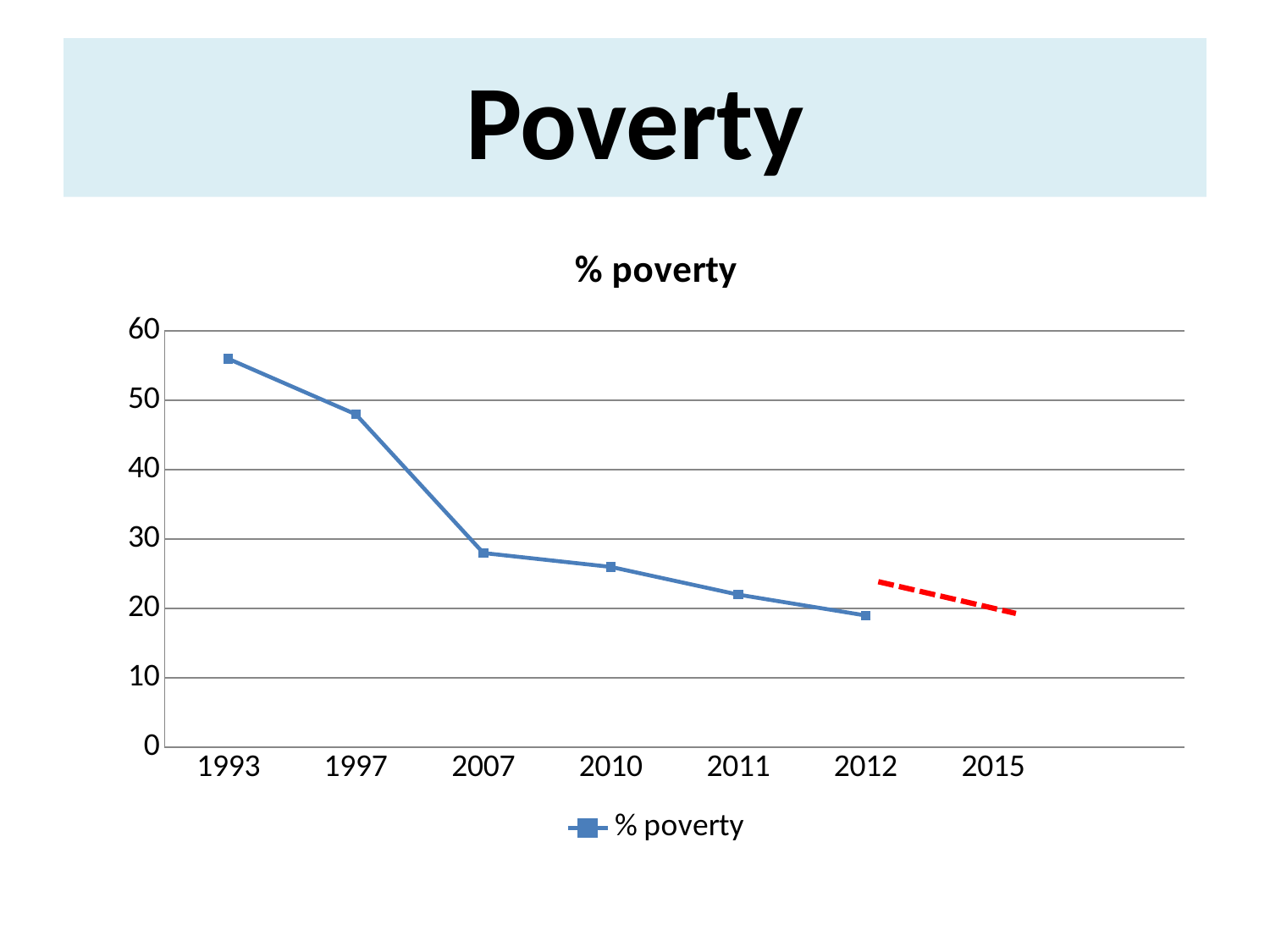
What is the title of the chart? % poverty Is the % poverty value for 1993 greater or less than 50? greater What colour is the dashed line drawn near 2015? red What kind of chart is shown on the slide? line chart How many series does the legend list? 1 Which year has the highest % poverty value on the blue line? 1993 Is the % poverty value for 2007 greater or less than 30? less Which year has a higher % poverty value, 1997 or 2010? 1997 Which year has the lowest plotted % poverty value on the blue line? 2012 Is the % poverty value for 1997 greater or less than 40? greater Do the % poverty values rise or fall from 1993 to 2012? fall How many year labels are shown on the x axis? 7